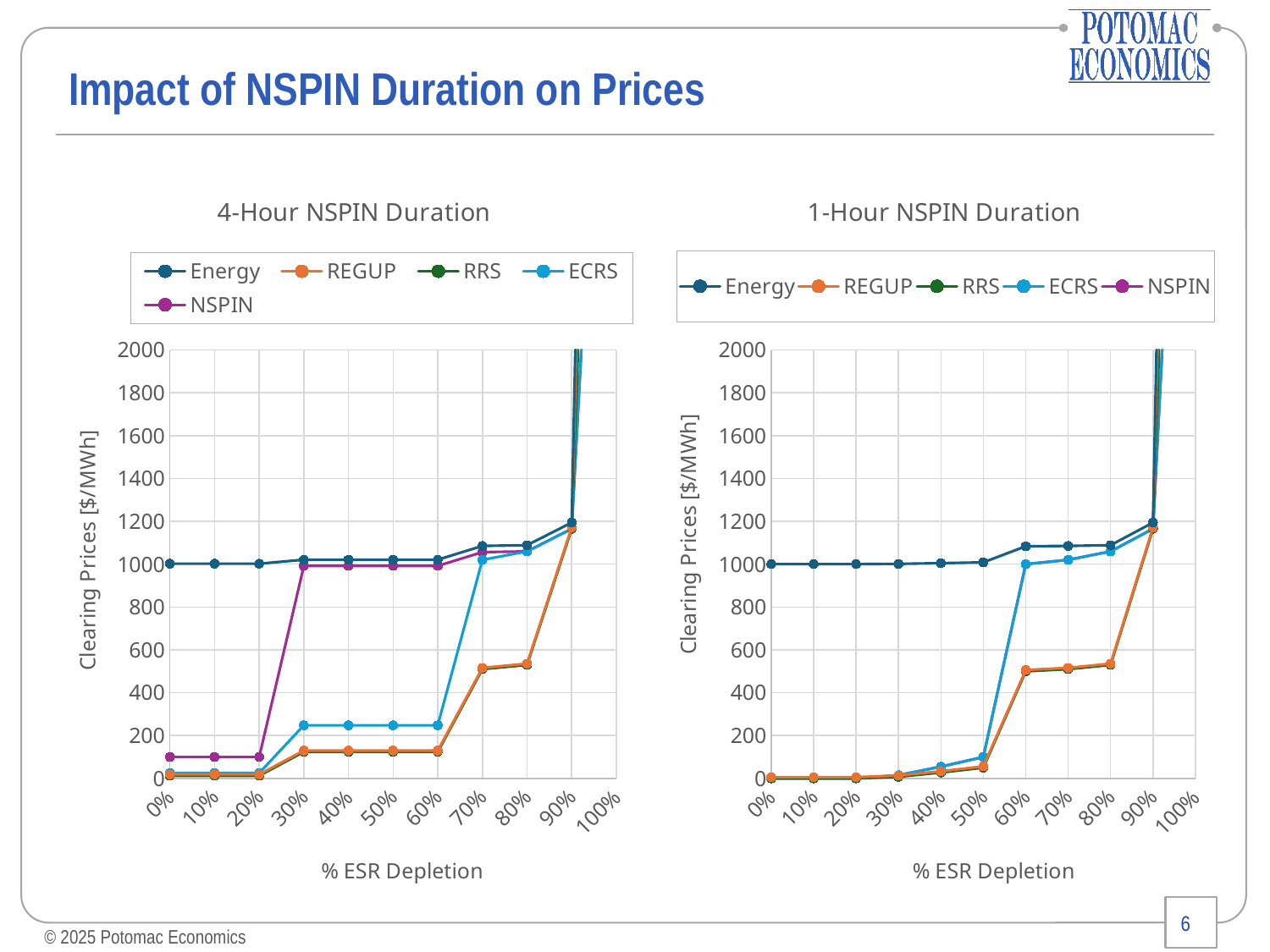
In the 4-Hour NSPIN Duration chart, which is larger at 30% ESR depletion, NSPIN or ECRS? NSPIN How many series does the legend of the 4-Hour NSPIN Duration chart list? 5 In the 1-Hour NSPIN Duration chart, is the ECRS value at 60% ESR depletion greater or less than 800? greater In the 1-Hour NSPIN Duration chart, is the REGUP value at 50% ESR depletion greater or less than 200? less In the 4-Hour NSPIN Duration chart, is the ECRS value at 40% ESR depletion greater or less than 400? less How many series does the legend of the 1-Hour NSPIN Duration chart list? 5 What type of chart is the 4-Hour NSPIN Duration chart? line chart In the 1-Hour NSPIN Duration chart, do the REGUP values rise or fall as % ESR depletion increases? rise What is the y-axis title of the 1-Hour NSPIN Duration chart? Clearing Prices [$/MWh] In the 4-Hour NSPIN Duration chart, which series has the highest value at 0% ESR depletion? Energy